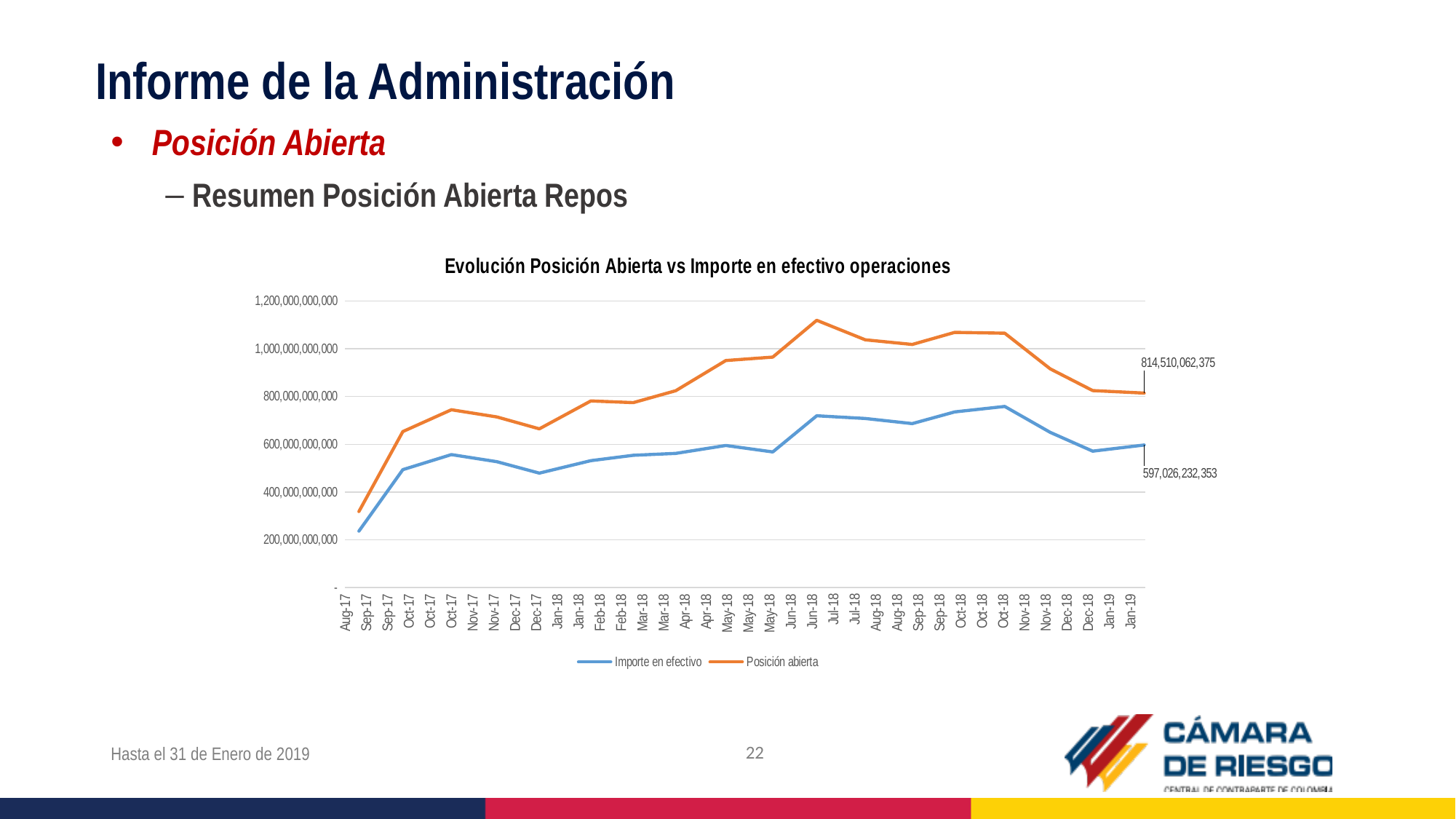
Is the peak value of Posición abierta around Jun-18 greater or less than 1,000,000,000,000? greater Does the Posición abierta line rise or fall between Aug-17 and Oct-17? rise What is the labelled value of Importe en efectivo at the end of the series (Jan-19)? 597,026,232,353 What is the title of the chart? Evolución Posición Abierta vs Importe en efectivo operaciones What is the labelled value of Posición abierta at the end of the series (Jan-19)? 814,510,062,375 What kind of chart is shown on the slide? line chart Is the value of Importe en efectivo at Oct-18 greater or less than 600,000,000,000? greater What is the difference between the labelled Jan-19 values of Posición abierta and Importe en efectivo? 217,483,830,022 At Jan-19, which series has the larger labelled value, Posición abierta or Importe en efectivo? Posición abierta Is the value of Importe en efectivo at Aug-17 greater or less than 400,000,000,000? less How many series does the legend of the chart list? 2 What colour is the Posición abierta line in the chart? orange